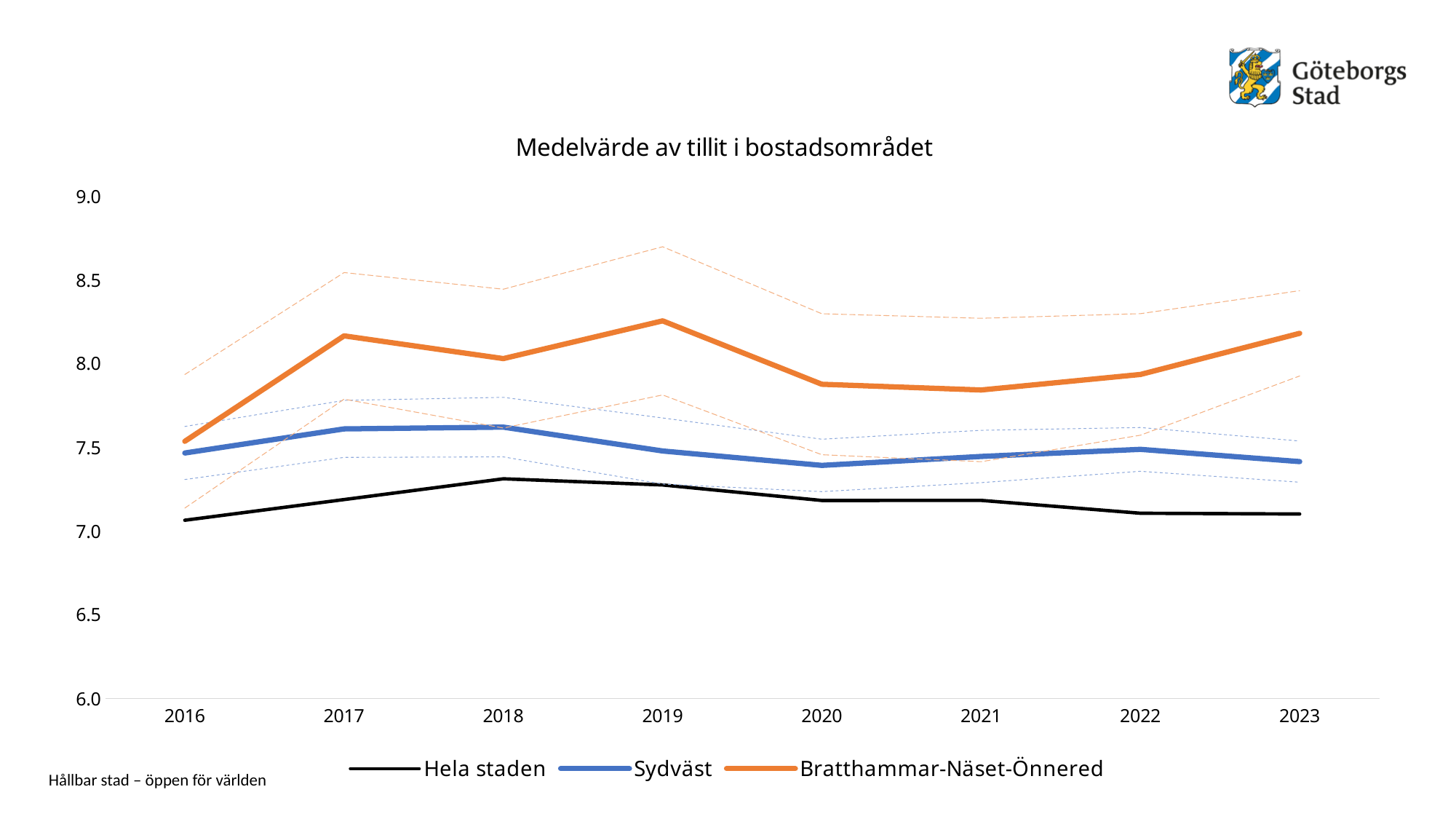
What kind of chart is shown on the slide? line chart Which year has the lowest value for Bratthammar-Näset-Önnered? 2016 How many years are shown on the x axis? 8 Which year has the highest value for Bratthammar-Näset-Önnered? 2019 Is the value for Hela staden in 2018 greater or less than 7.5? less What colour is the Bratthammar-Näset-Önnered line? orange How many series does the legend list? 3 Is the value for Bratthammar-Näset-Önnered in 2019 greater or less than 8.0? greater In 2019, which series has the larger value, Sydväst or Bratthammar-Näset-Önnered? Bratthammar-Näset-Önnered What is the title of the chart? Medelvärde av tillit i bostadsområdet Is the value for Sydväst in 2020 greater or less than 7.5? less Does the Hela staden line rise or fall from 2018 to 2023? fall